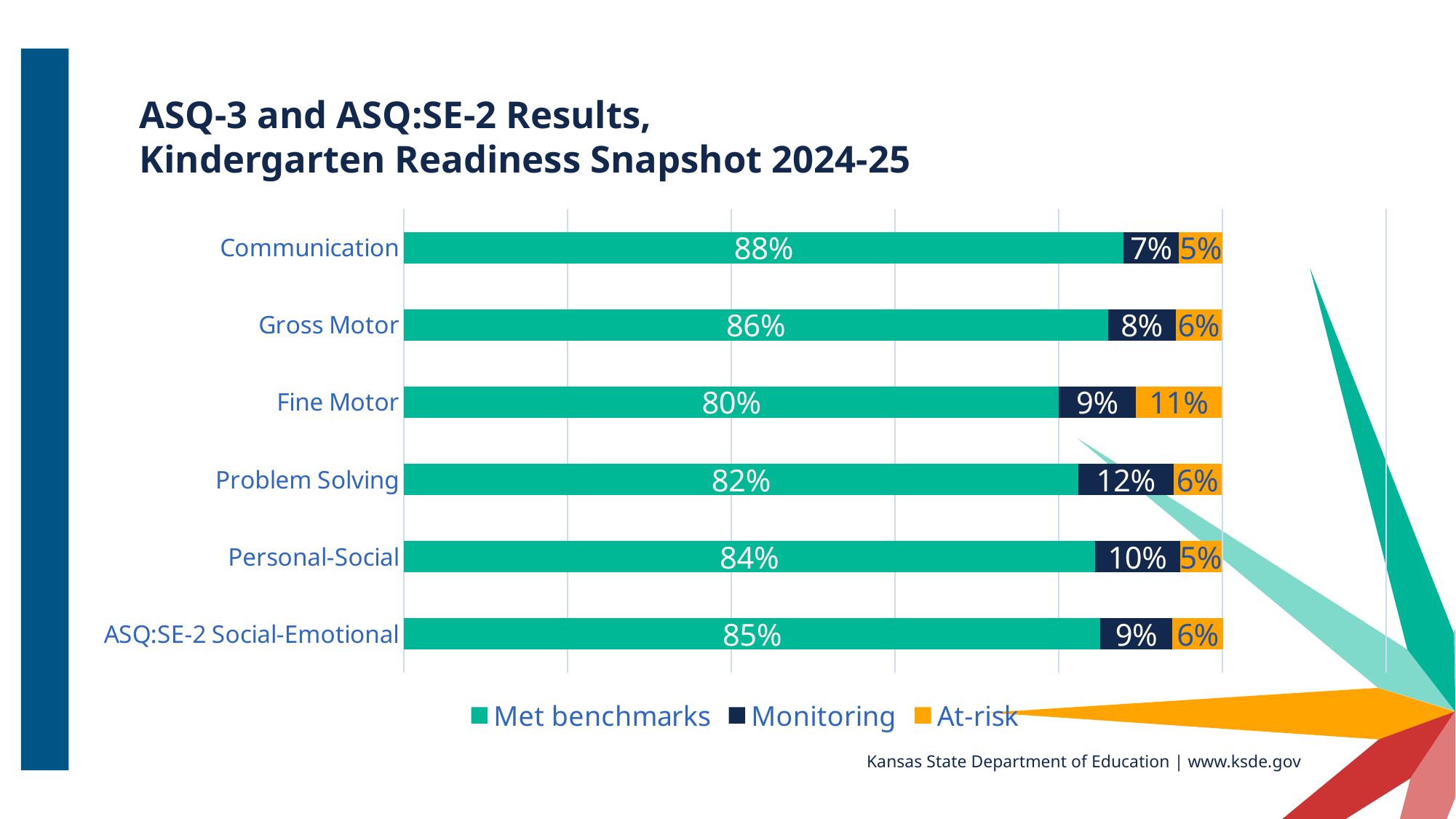
Which category has the highest Met benchmarks percentage? Communication What percentage met benchmarks in ASQ:SE-2 Social-Emotional? 85% What is the At-risk percentage for Fine Motor? 11% How many series does the legend list? 3 Which is larger, the Monitoring percentage for Gross Motor or for Personal-Social? Personal-Social What percentage of children met benchmarks in Communication? 88% What is the Monitoring percentage for Problem Solving? 12% Which category has the lowest Met benchmarks percentage? Fine Motor How many categories are shown on the chart? 6 What is the difference between the Met benchmarks percentages for Communication and Fine Motor? 8% What kind of chart is shown on the slide? Stacked bar chart Which category has the highest At-risk percentage? Fine Motor